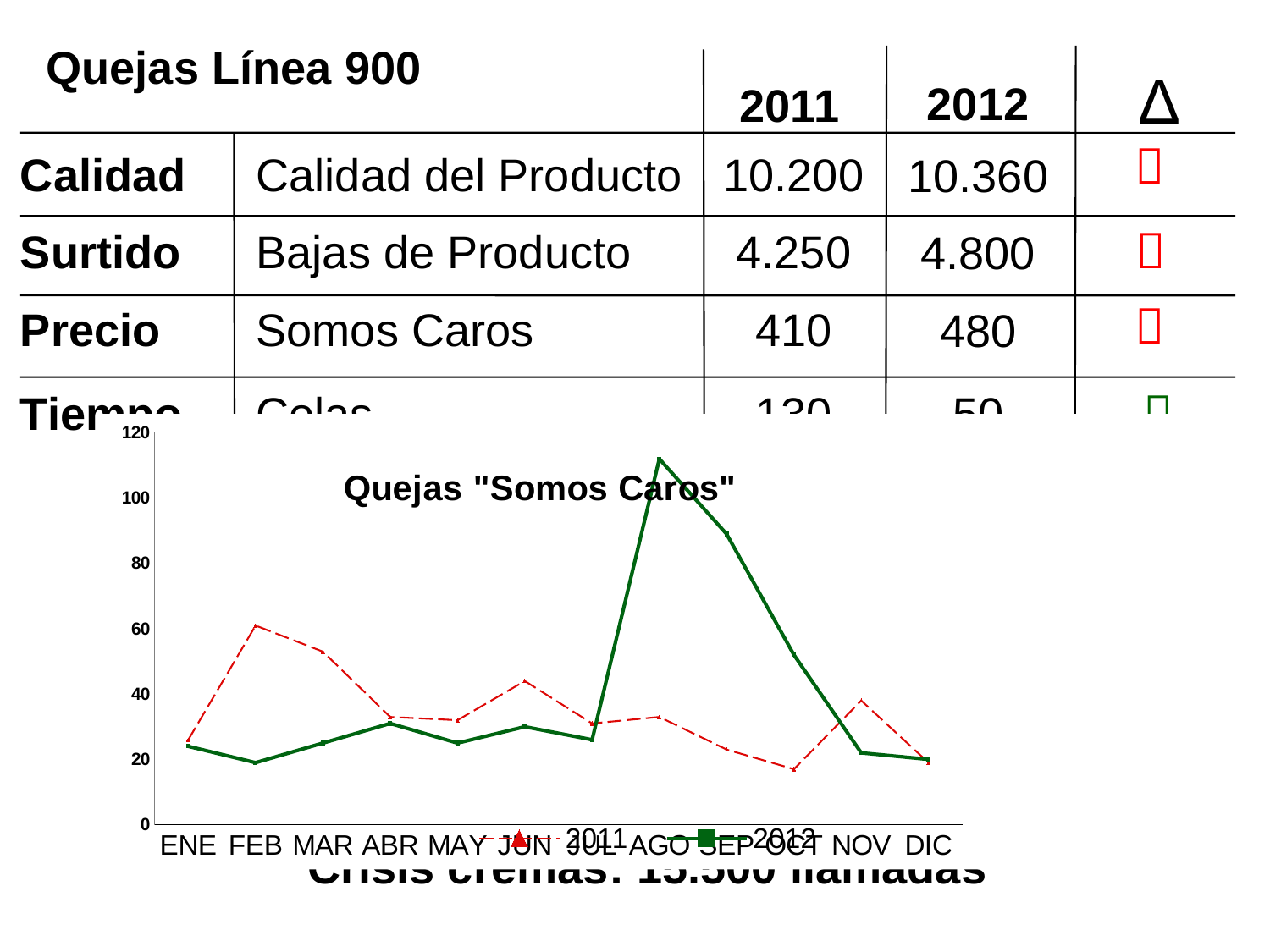
In which month does the 2011 series reach its lowest value? OCT Does the 2012 series rise or fall from AGO to DIC? fall Which series has the larger value in AGO, 2011 or 2012? 2012 How many months are shown on the x axis of the chart? 12 How many series does the chart legend list? 2 In which month does the 2012 series reach its highest value? AGO Is the 2011 value for FEB greater or less than 40? greater In which month does the 2011 series reach its highest value? FEB What is the title of the chart? Quejas "Somos Caros" What kind of chart is shown on the slide? line chart Is the 2012 value for AGO greater or less than 100? greater Which two series are listed in the chart legend? 2011 and 2012